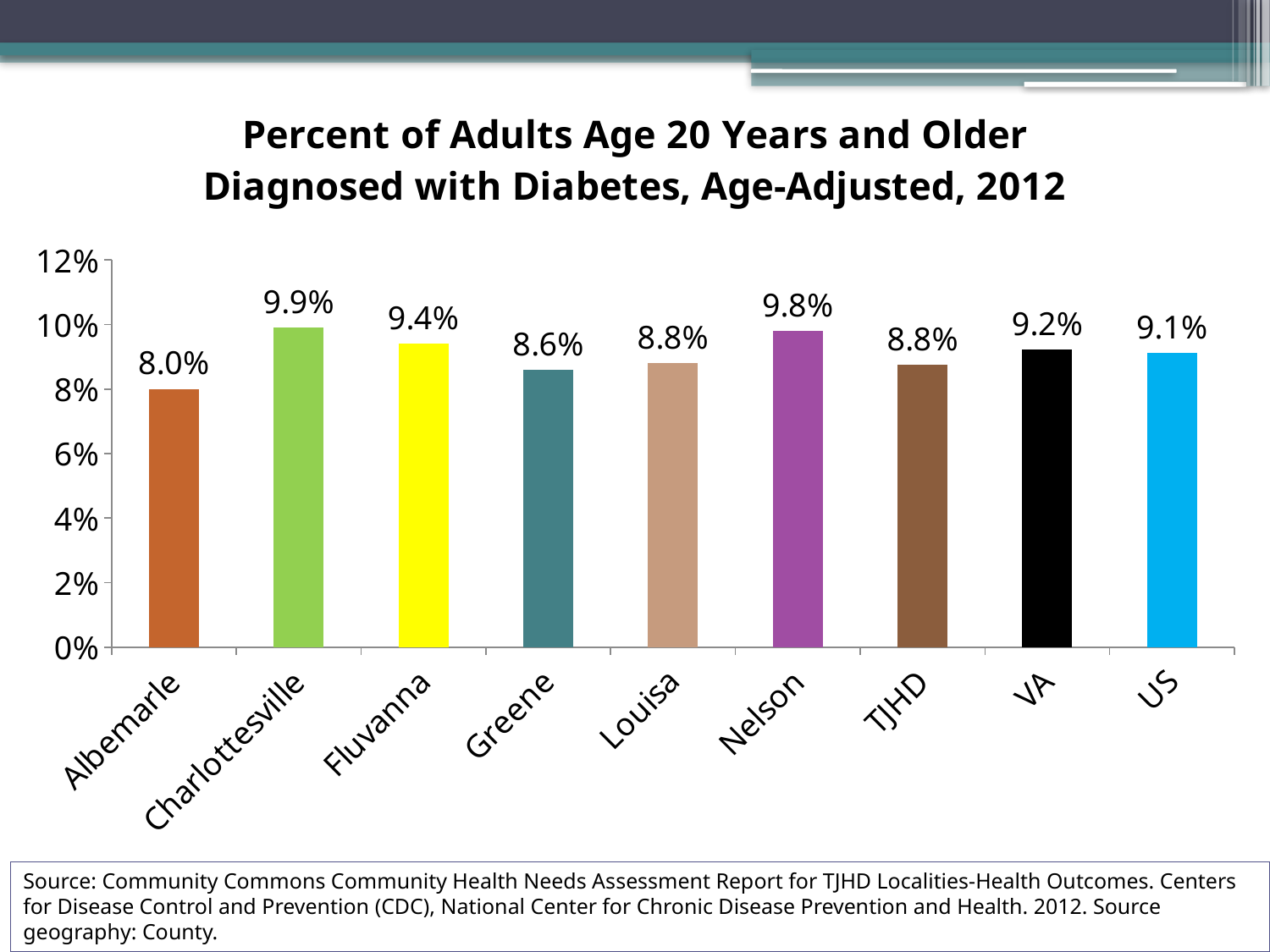
What is the value for Nelson? 9.8% What is the difference between the values for Charlottesville and Albemarle? 1.9% Which is larger, the value for Fluvanna or the value for US? Fluvanna What is the value for Albemarle? 8.0% Which category has the highest value? Charlottesville What kind of chart is shown on the slide? bar chart How many categories are shown on the x axis? 9 What is the difference between the values for Fluvanna and Greene? 0.8% What is the title of the chart? Percent of Adults Age 20 Years and Older Diagnosed with Diabetes, Age-Adjusted, 2012 Is the value for Greene greater or less than 10%? less What is the value for VA? 9.2% Which category has the lowest value? Albemarle